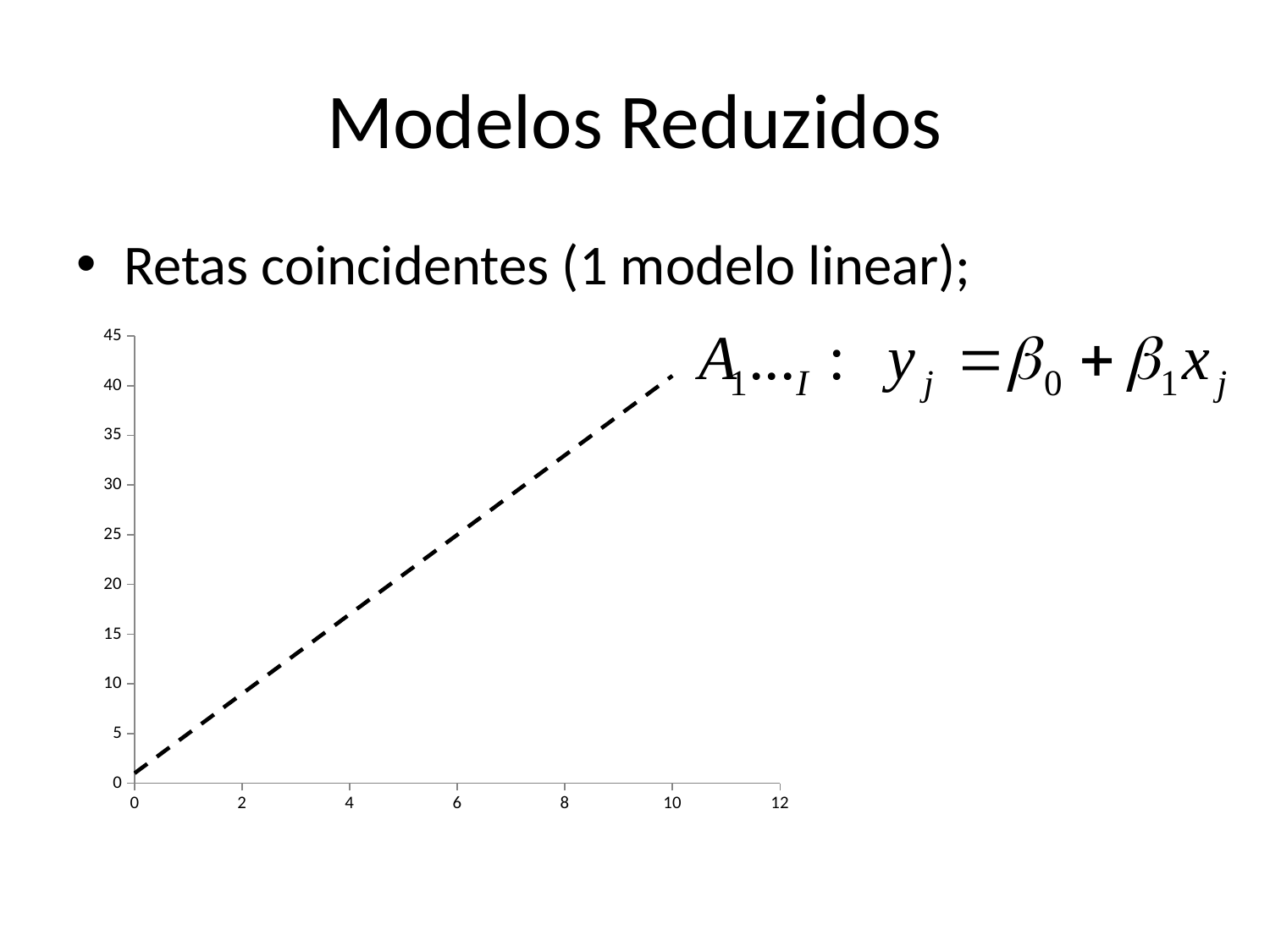
Is the value of the line at x = 2 greater or less than 15? less What is the highest value shown on the vertical axis of the chart? 45 Is the value of the line at x = 4 greater or less than 10? greater Is the value of the line at x = 10 greater or less than 35? greater Is the line on the chart drawn as a solid or a dashed line? dashed What kind of chart is shown on the slide? line chart Is the value of the line at x = 10 larger than the value at x = 0? yes Do the values on the chart rise or fall as x increases from 0 to 10? rise